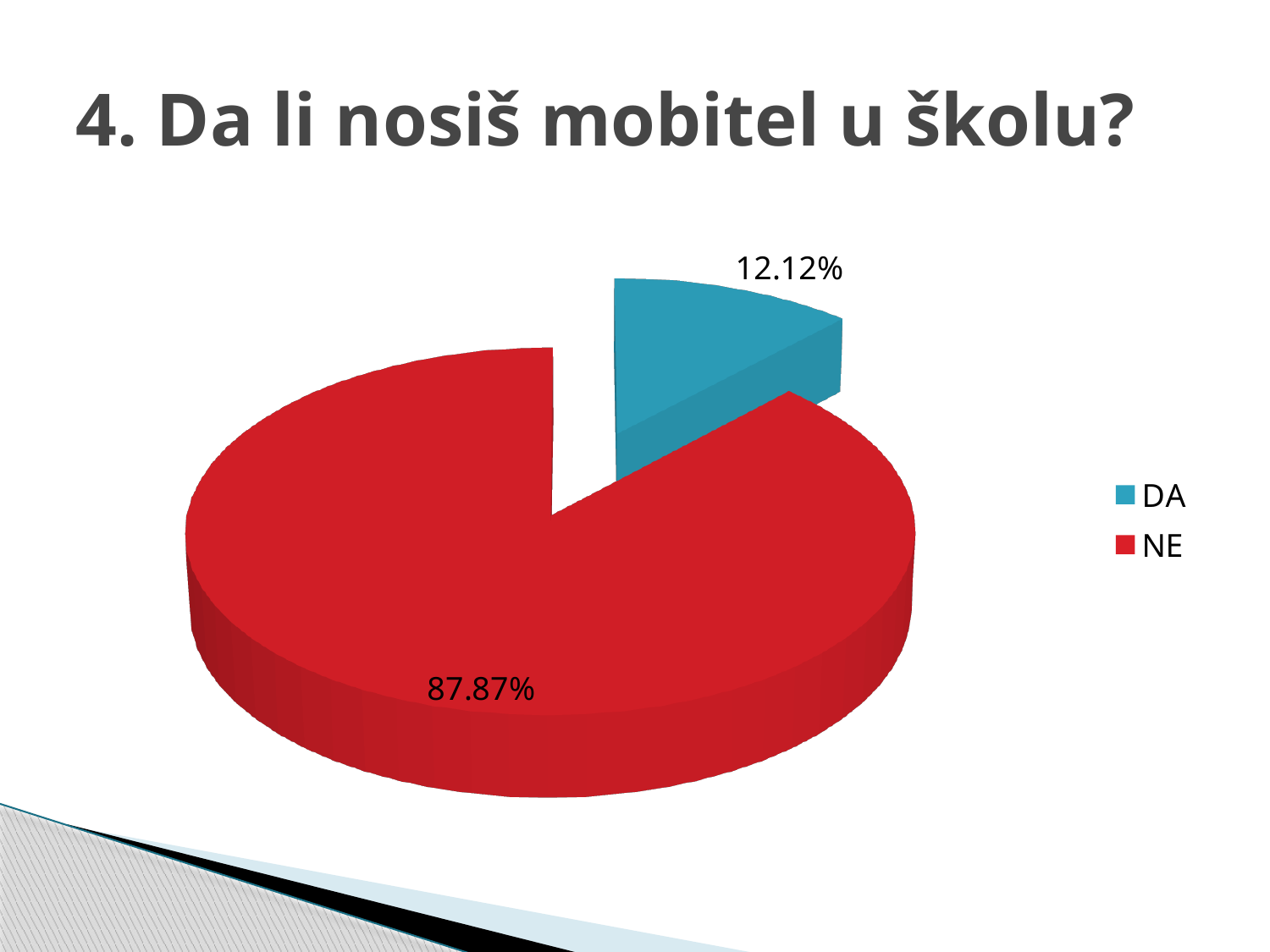
What is the difference between the NE share and the DA share? 75.75% What percentage is shown for DA? 12.12% Which category has the smallest share of the pie? DA What is the title of the slide above the chart? 4. Da li nosiš mobitel u školu? Which category has the largest share of the pie? NE How many entries does the legend list? 2 How many slices does the pie chart have? 2 What kind of chart is shown on the slide? pie chart What colour is the DA slice? blue What percentage is shown for NE? 87.87% Which is larger, the share for DA or the share for NE? NE